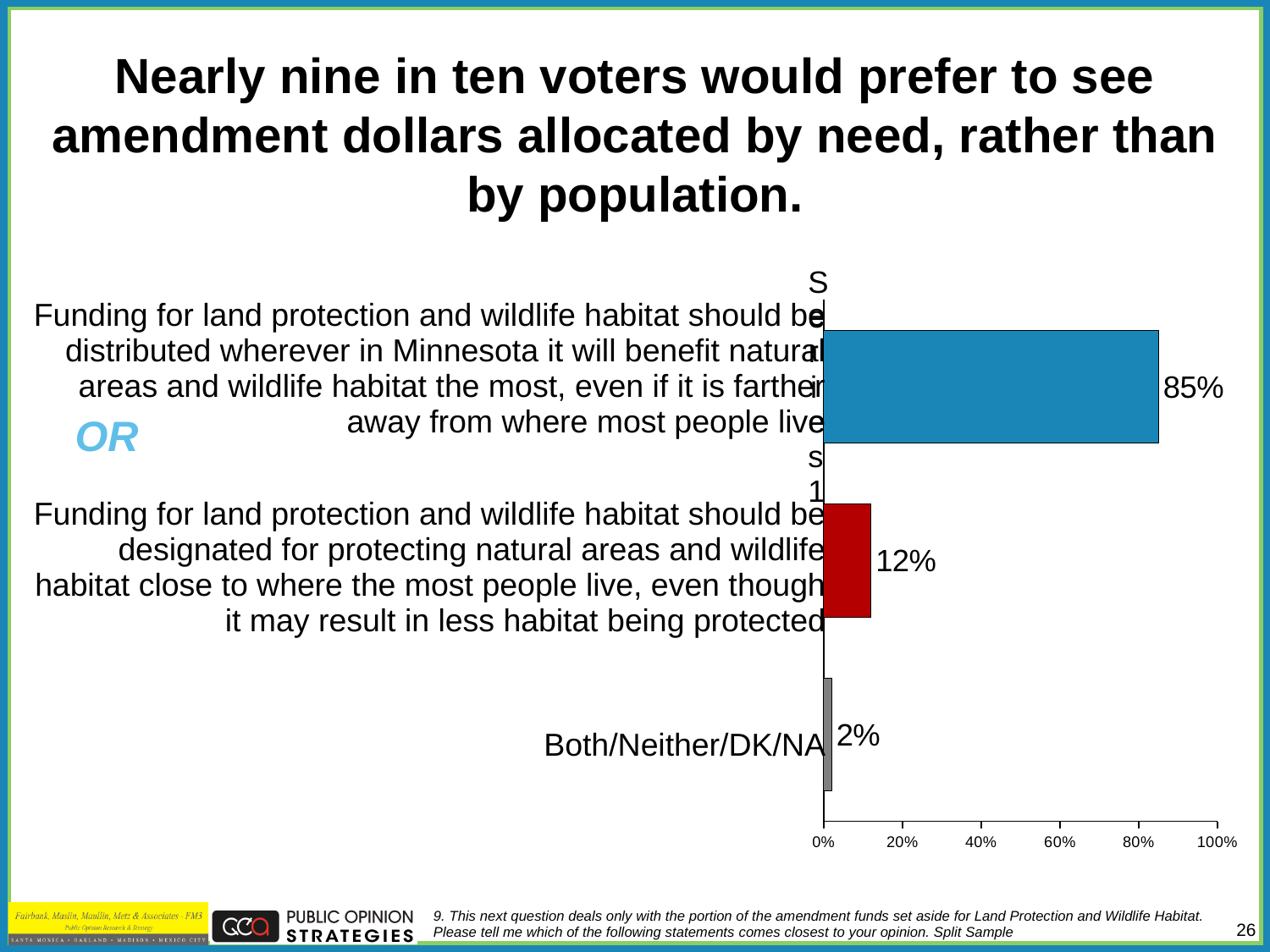
What type of chart is shown on the slide? Bar chart What percentage of voters chose the statement that funding should be designated for protecting habitat close to where the most people live? 12% How many response categories are shown in the chart? 3 Which response category has the highest value? Funding should be distributed wherever in Minnesota it will benefit natural areas and wildlife habitat the most What is the maximum value shown on the chart's horizontal axis? 100% What is the value shown for Both/Neither/DK/NA? 2% What percentage of voters chose the statement that funding should be distributed wherever in Minnesota it will benefit natural areas and wildlife habitat the most? 85% What is the difference between the value for the 'close to where the most people live' statement and Both/Neither/DK/NA? 10 percentage points Which response category has the lowest value? Both/Neither/DK/NA Which is larger: the share choosing the 'close to where the most people live' statement or the share answering Both/Neither/DK/NA? The 'close to where the most people live' statement What is the difference in percentage points between the two funding statements (85% and 12%)? 73 percentage points Is the value for the 'distributed wherever it will benefit habitat the most' statement greater or less than 80%? greater